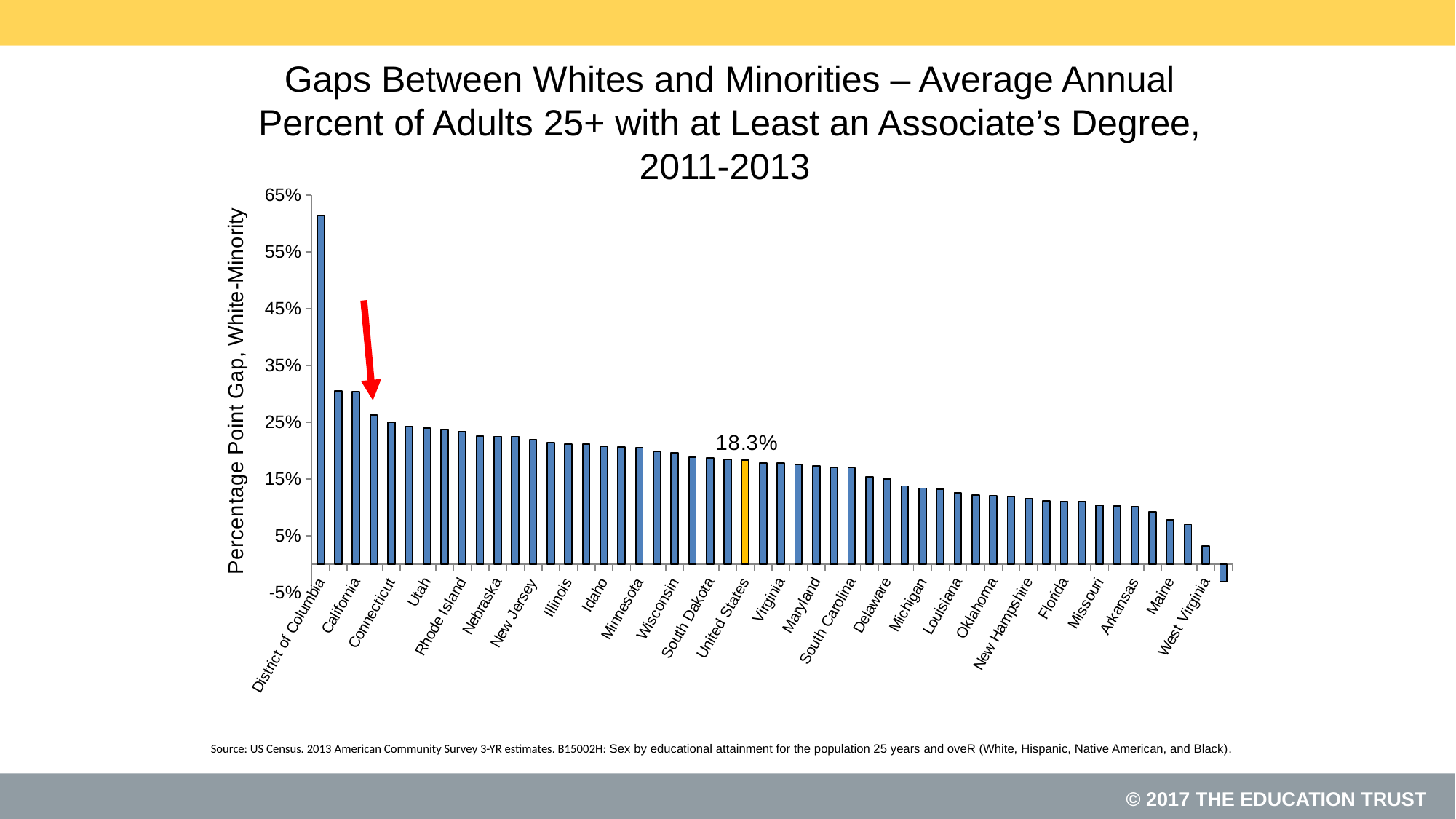
Is the value for District of Columbia greater or less than 55%? greater Is the value for Idaho greater or less than 15%? greater Which is larger, the value for Connecticut or the value for Maine? Connecticut Which is larger, the value for Florida or the value for Illinois? Illinois What is the value shown for United States? 18.3% Do the values rise or fall moving from left to right along the x axis? Fall Which category has the highest value? District of Columbia Is the value for West Virginia greater or less than 5%? less What kind of chart is shown on the slide? Bar chart Which category's bar is highlighted in yellow? United States